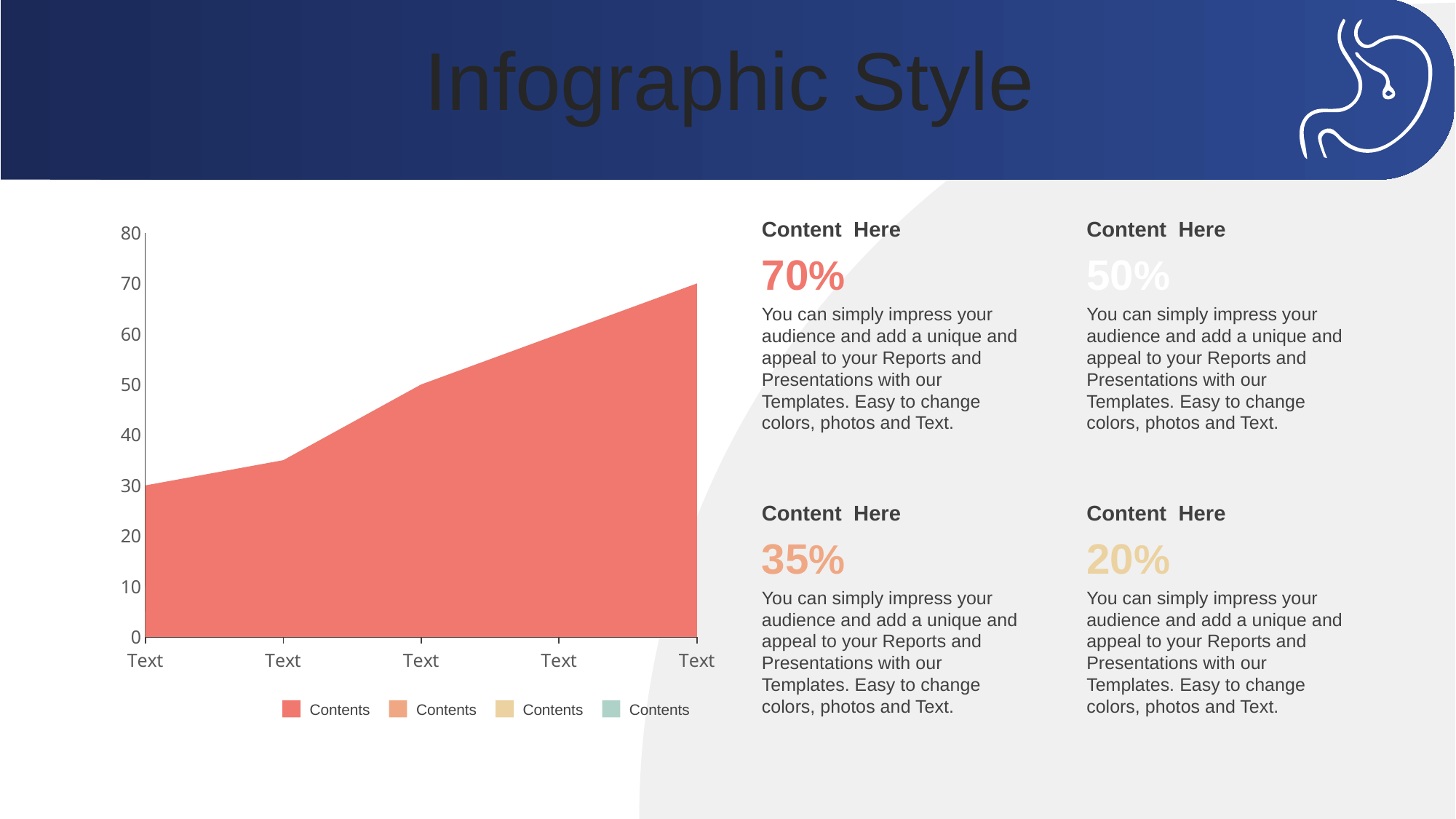
Do the values in the chart rise or fall from left to right along the x axis? rise Is the value of the second point from the left greater or less than 40? less How many series does the chart's legend list? 4 Which point in the chart has the highest value? the last (rightmost) point What label is used for every entry in the chart's legend? Contents What is the value of the fourth point from the left in the chart? 60 How many data points are plotted along the x axis of the chart? 5 Which point in the chart has the lowest value? the first (leftmost) point What is the value of the first (leftmost) point in the chart? 30 What is the difference between the last point's value and the first point's value in the chart? 40 What is the value of the last (rightmost) point in the chart? 70 What kind of chart is shown on the slide? area chart